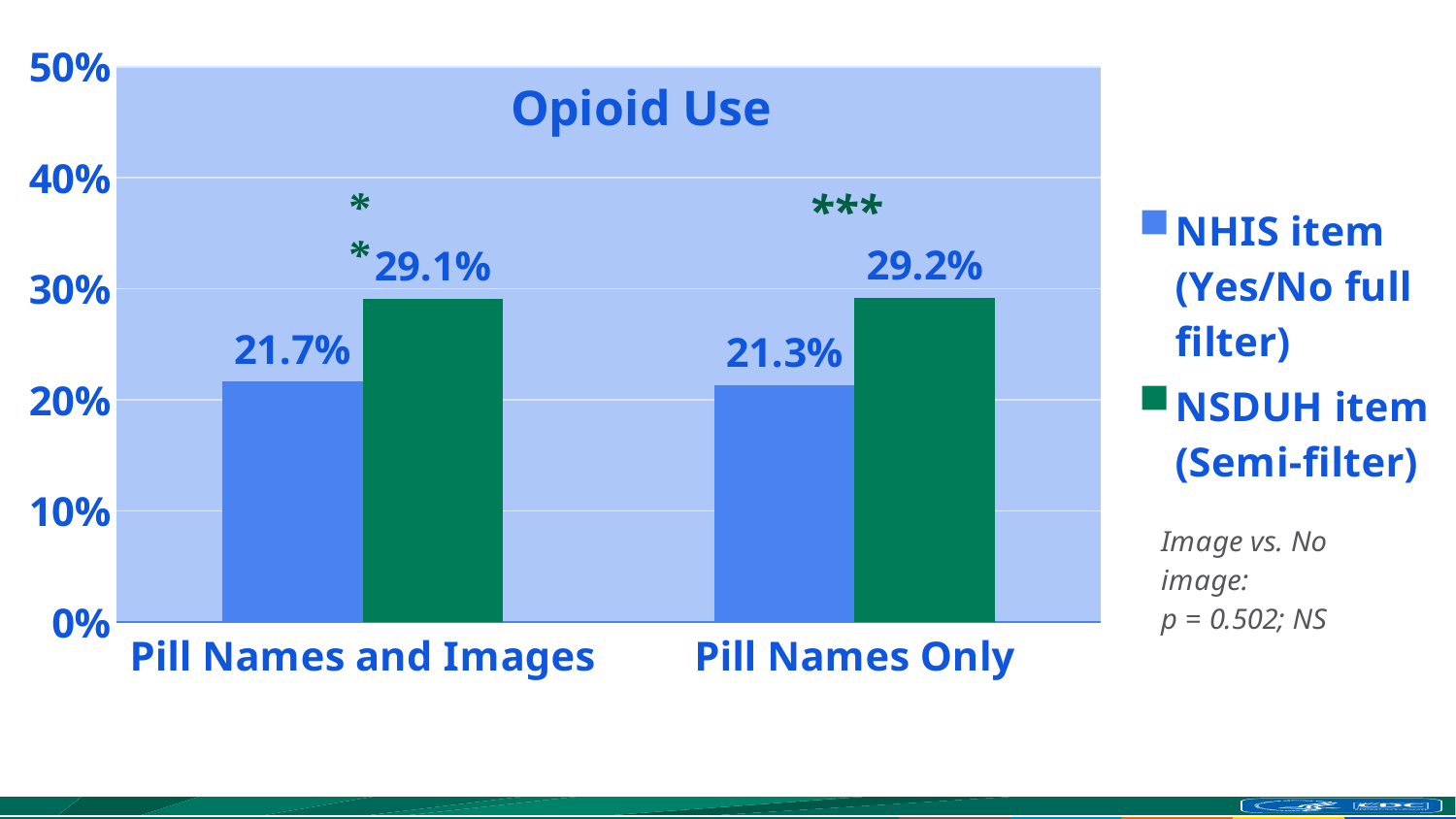
In the Pill Names Only category, which is larger: the NHIS item or the NSDUH item? NSDUH item How many categories are shown on the x axis? 2 Is the value for the NHIS item in the Pill Names and Images category greater or less than 20%? greater How many series does the legend list? 2 What is the difference between the NSDUH item and the NHIS item values in the Pill Names and Images category? 7.4% What is the value for the NHIS item (Yes/No full filter) in the Pill Names and Images category? 21.7% What is the value for the NSDUH item (Semi-filter) in the Pill Names and Images category? 29.1% What type of chart is shown on the slide? Bar chart Which bar has the lowest value on the chart? NHIS item (Yes/No full filter), Pill Names Only What is the value for the NSDUH item (Semi-filter) in the Pill Names Only category? 29.2% What is the value for the NHIS item (Yes/No full filter) in the Pill Names Only category? 21.3% What is the difference between the NSDUH item and the NHIS item values in the Pill Names Only category? 7.9%